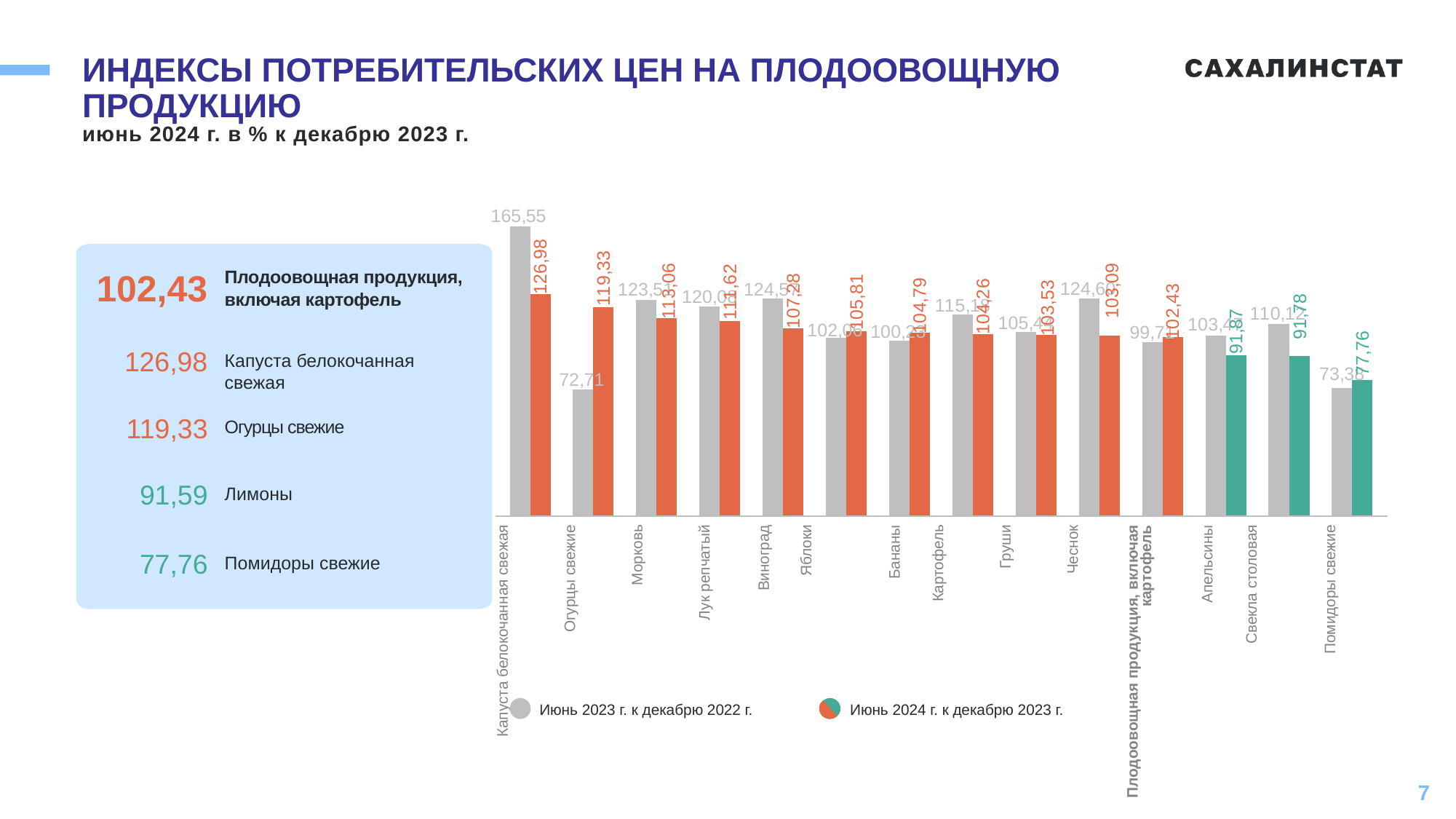
Which category has the lowest value in the series Июнь 2024 г. к декабрю 2023 г.? Помидоры свежие For Огурцы свежие, which series has the larger value: Июнь 2023 г. к декабрю 2022 г. or Июнь 2024 г. к декабрю 2023 г.? Июнь 2024 г. к декабрю 2023 г. What is the difference between the two series values for Огурцы свежие? 46,62 Which category has the highest value in the series Июнь 2024 г. к декабрю 2023 г.? Капуста белокочанная свежая How many categories are shown on the x axis of the chart? 14 How many series does the legend list? 2 What kind of chart is shown on the slide? Bar chart What is the value for Капуста белокочанная свежая in the series Июнь 2024 г. к декабрю 2023 г.? 126,98 What is the difference between the two series values for Капуста белокочанная свежая? 38,57 What is the value for Яблоки in the series Июнь 2024 г. к декабрю 2023 г.? 105,81 Which category has the highest value in the series Июнь 2023 г. к декабрю 2022 г.? Капуста белокочанная свежая What is the value for Огурцы свежие in the series Июнь 2023 г. к декабрю 2022 г.? 72,71